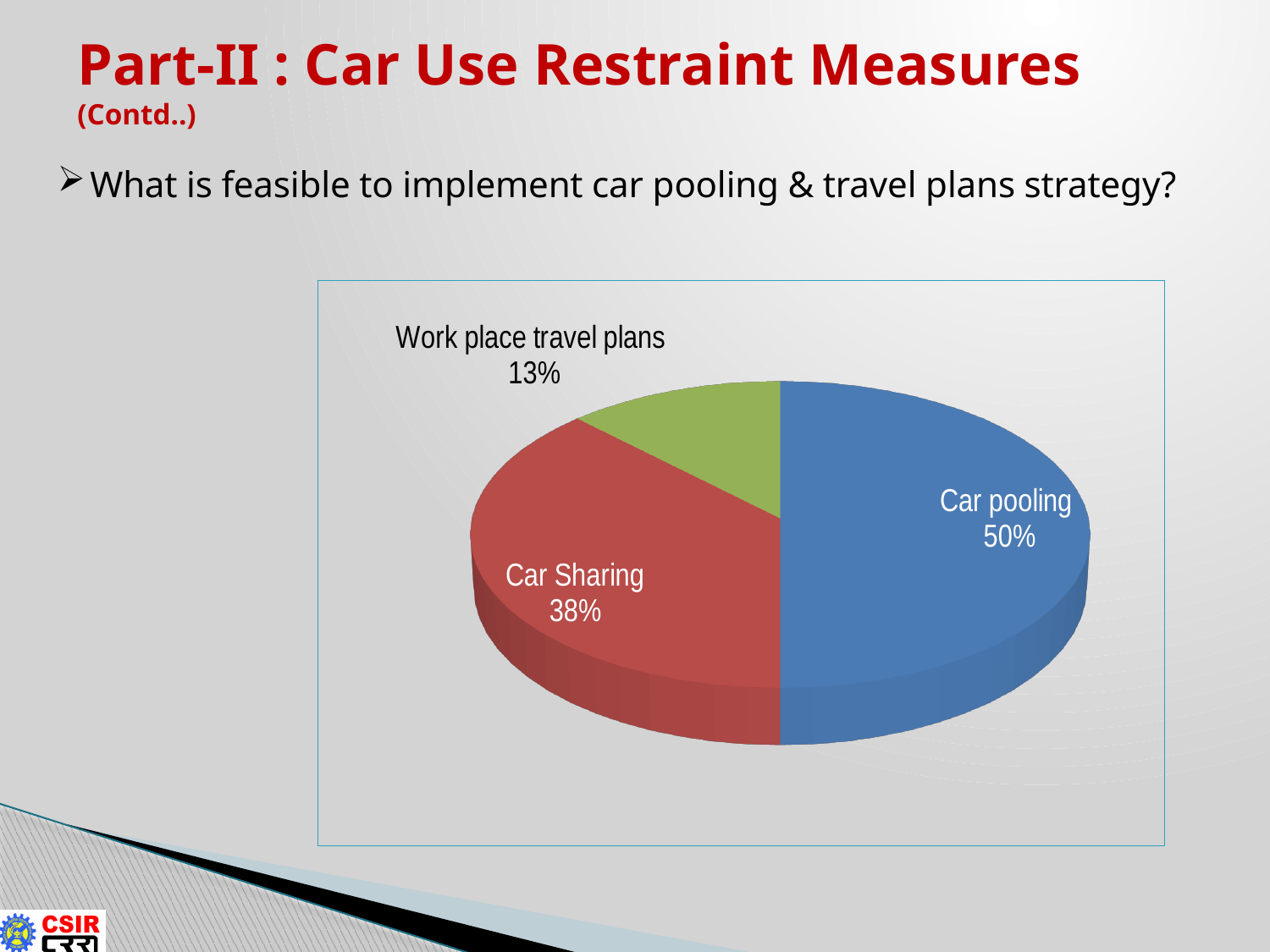
What colour is the Work place travel plans slice? green Which category has the smallest slice of the pie? Work place travel plans What is the difference between the Car Sharing and Work place travel plans shares? 25% What share of the pie does Car Sharing have? 38% What kind of chart is shown on the slide? pie chart What share of the pie does Work place travel plans have? 13% What is the difference between the Car pooling and Car Sharing shares? 12% Which category has the largest slice of the pie? Car pooling What share of the pie does Car pooling have? 50% How many categories are shown in the pie chart? 3 What colour is the Car pooling slice? blue Which is larger, the share for Car Sharing or the share for Work place travel plans? Car Sharing